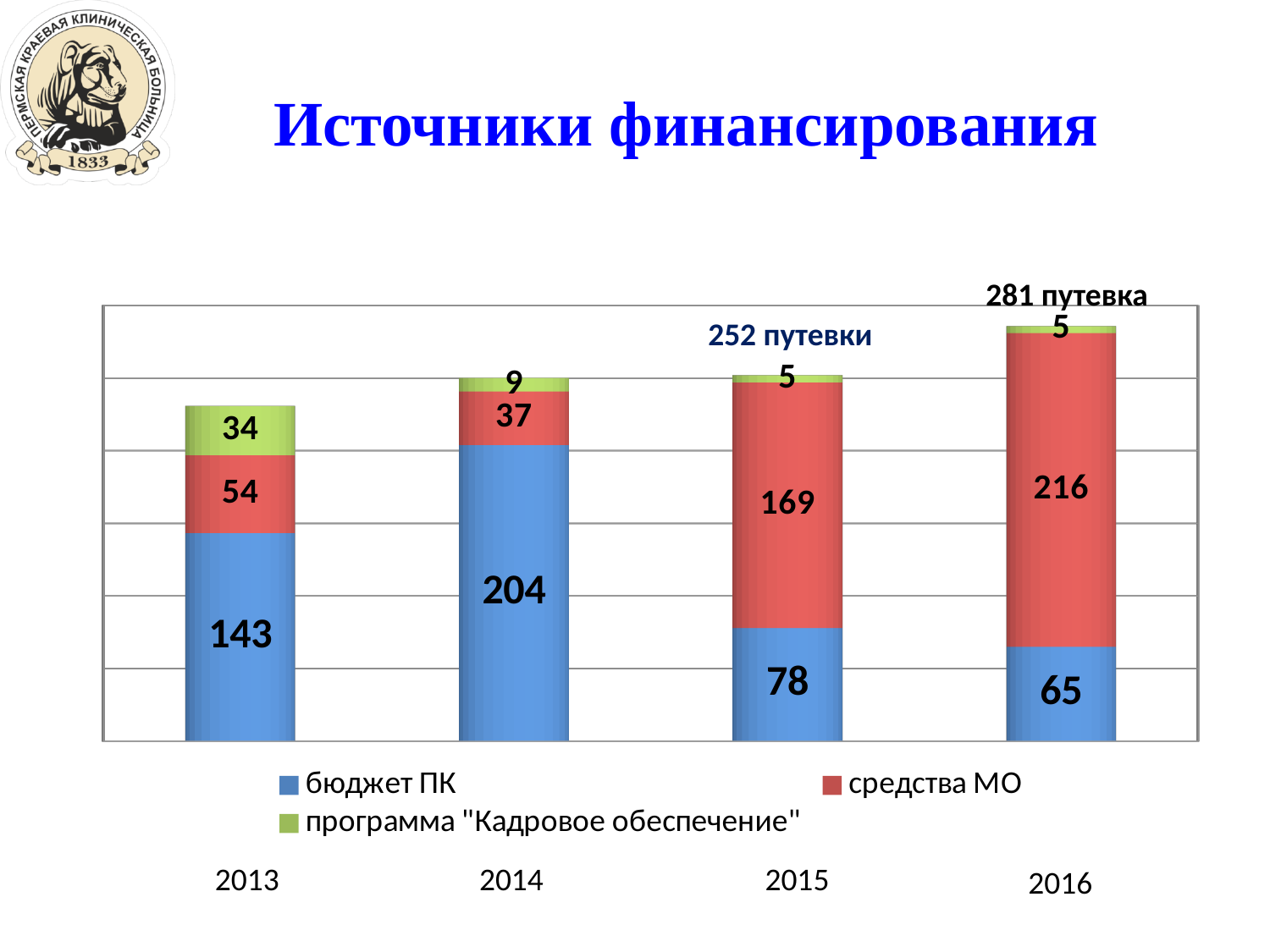
What is the value of программа "Кадровое обеспечение" in 2013? 34 What is the value of бюджет ПК in 2014? 204 How many years (categories) are shown on the x axis? 4 What is the title of the chart on the slide? Источники финансирования Which is larger in 2015: бюджет ПК or средства МО? средства МО What type of chart is shown on the slide? stacked bar chart In which year is the бюджет ПК value the highest? 2014 What is the total of the stacked bar for 2013? 231 What is the difference between the средства МО values in 2016 and 2015? 47 How many series does the legend list? 3 In which year is the средства МО value the lowest? 2014 What is the value of средства МО in 2016? 216